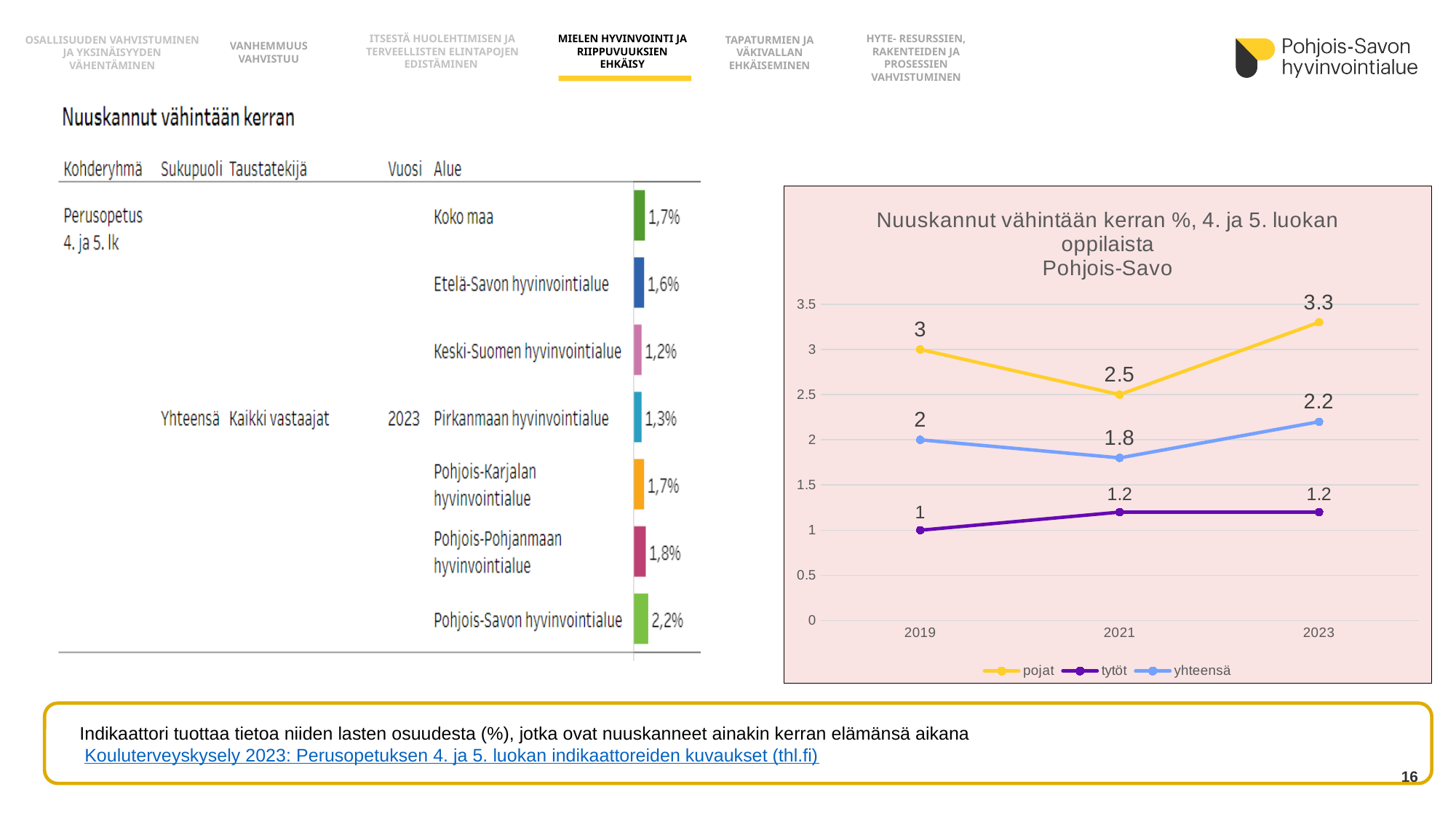
In the bar chart on the left, what is the value for Pohjois-Savon hyvinvointialue? 2,2% In the bar chart on the left, which area has the lowest value? Keski-Suomen hyvinvointialue In the line chart on the right, what is the value for pojat in 2023? 3.3 In the line chart on the right, in which year is the value for pojat lowest? 2021 What kind of chart is the chart on the right? line chart In the line chart on the right, does the yhteensä series rise or fall from 2021 to 2023? rise In the bar chart on the left, which is larger, the value for Koko maa or for Pirkanmaan hyvinvointialue? Koko maa In the line chart on the right, how many series does the legend list? 3 In the bar chart on the left, how many areas are shown? 7 In the line chart on the right, what is the difference between pojat and tytöt in 2023? 2.1 In the line chart on the right, what is the value for yhteensä in 2021? 1.8 In the line chart on the right, what is the value for tytöt in 2019? 1